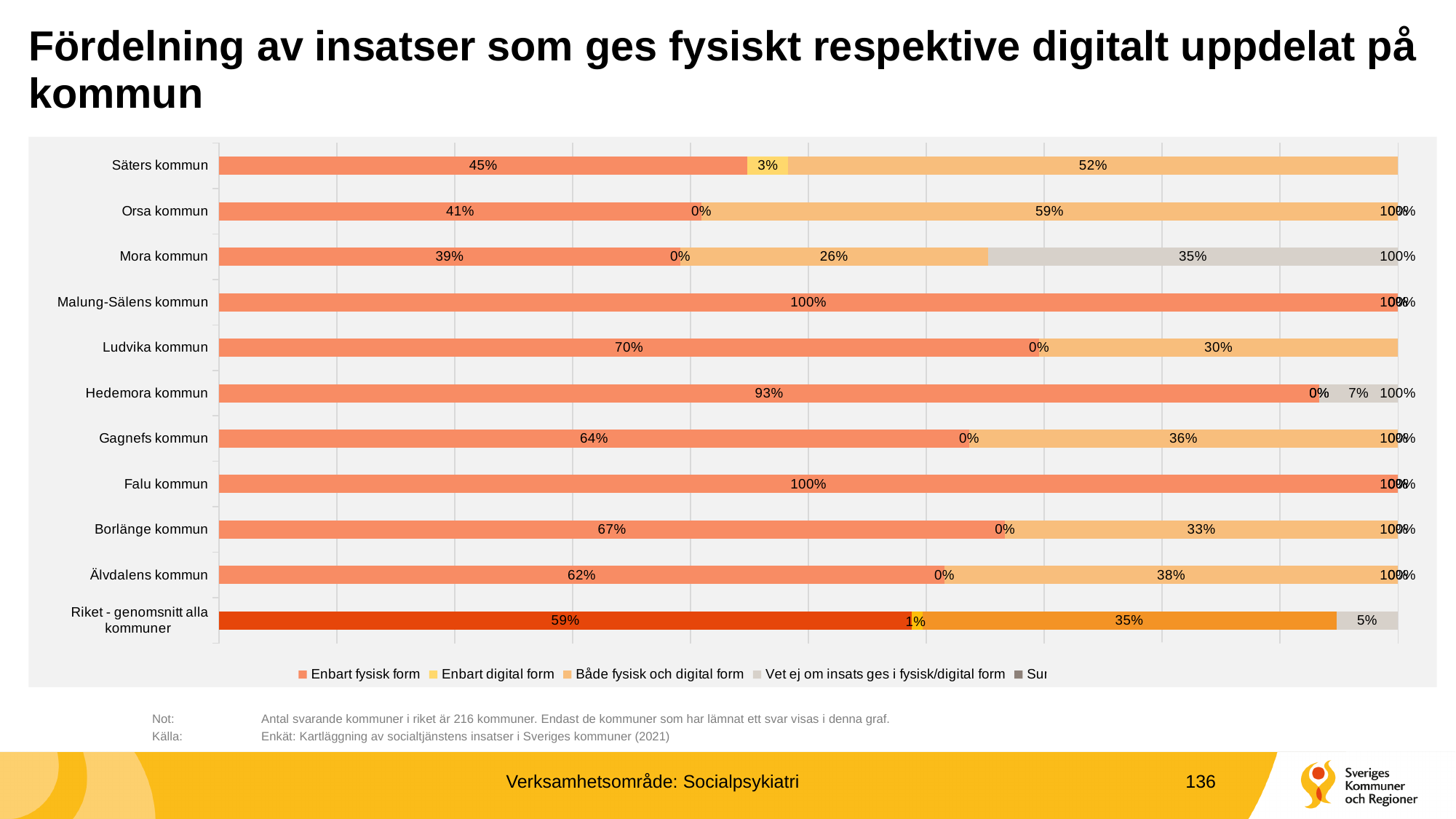
What is the value of Enbart fysisk form for Säters kommun? 45% What is the value of Vet ej om insats ges i fysisk/digital form for Mora kommun? 35% What is the difference between Enbart fysisk form and Både fysisk och digital form for Ludvika kommun? 40 percentage points What is the value of Både fysisk och digital form for Orsa kommun? 59% Which has a larger value for Enbart fysisk form, Borlänge kommun or Älvdalens kommun? Borlänge kommun What type of chart is shown on the slide? Stacked bar chart How many categories (rows) are shown in the chart? 11 What is the value of Enbart digital form for Riket - genomsnitt alla kommuner? 1% Which kommun has the highest value for Både fysisk och digital form? Orsa kommun Which kommun has the lowest value for Enbart fysisk form? Mora kommun What is the value of Vet ej om insats ges i fysisk/digital form for Hedemora kommun? 7% What is the title of the chart on the slide? Fördelning av insatser som ges fysiskt respektive digitalt uppdelat på kommun